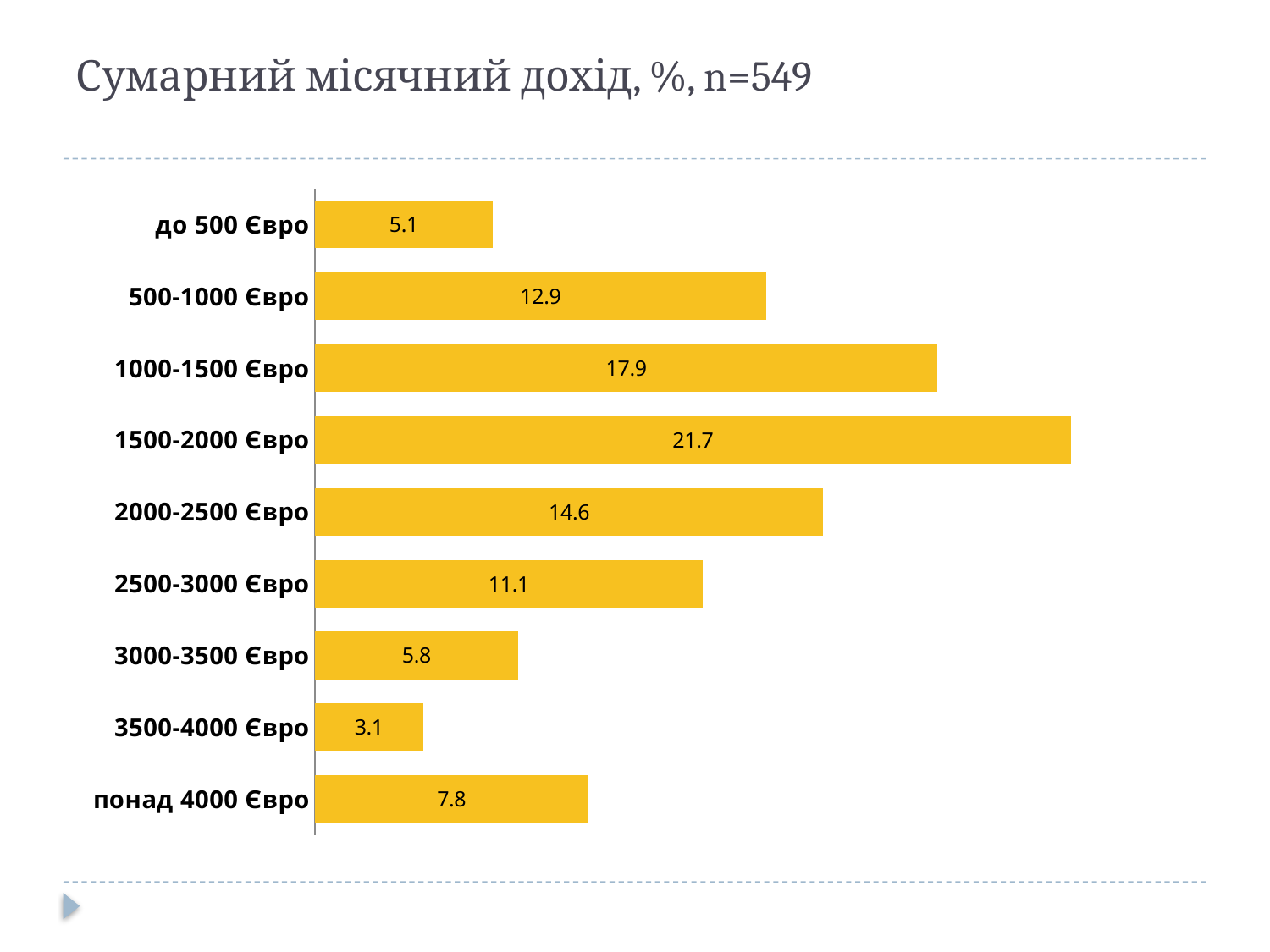
Which is larger, the value for 3000-3500 Євро or the value for понад 4000 Євро? понад 4000 Євро Which category has the highest value? 1500-2000 Євро What is the value for the понад 4000 Євро category? 7.8 What kind of chart is shown on the slide? bar chart What is the title of the slide? Сумарний місячний дохід, %, n=549 Which category has the lowest value? 3500-4000 Євро Which is larger, the value for 1000-1500 Євро or the value for 2000-2500 Євро? 1000-1500 Євро What is the difference between the values for 500-1000 Євро and 2500-3000 Євро? 1.8 How many categories are shown in the chart? 9 What is the value for the до 500 Євро category? 5.1 What is the difference between the values for 1500-2000 Євро and 2000-2500 Євро? 7.1 What is the value for the 1500-2000 Євро category? 21.7